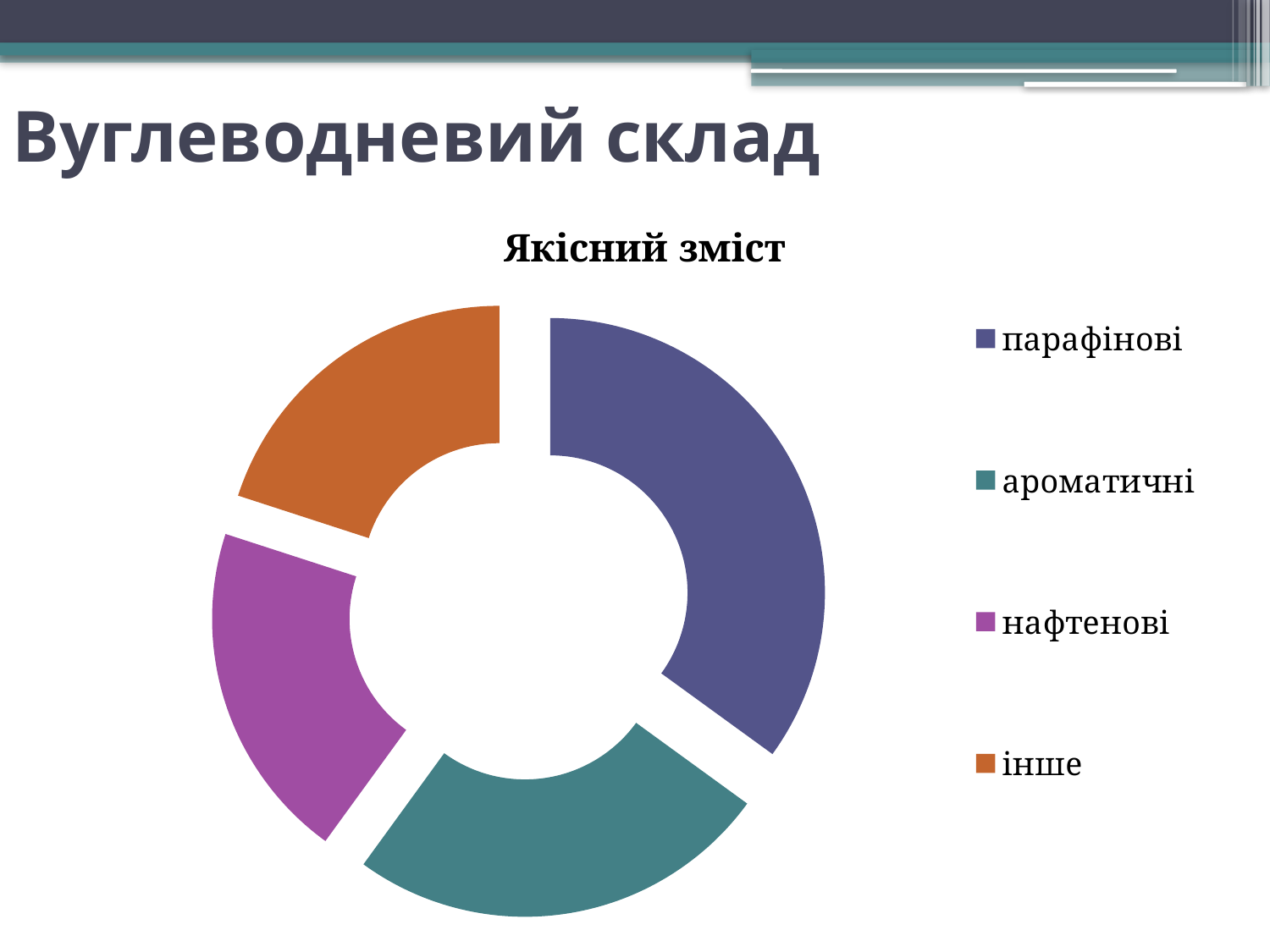
How many entries does the legend list? 4 Which category is shown in orange in the legend? інше How many categories does the chart show? 4 What is the title of the chart? Якісний зміст Which is larger, the share for парафінові or the share for інше? парафінові Which is larger, the share for нафтенові or the share for парафінові? парафінові Which is larger, the share for парафінові or the share for ароматичні? парафінові Which category has the largest share of the chart? парафінові What kind of chart is shown on the slide? doughnut chart